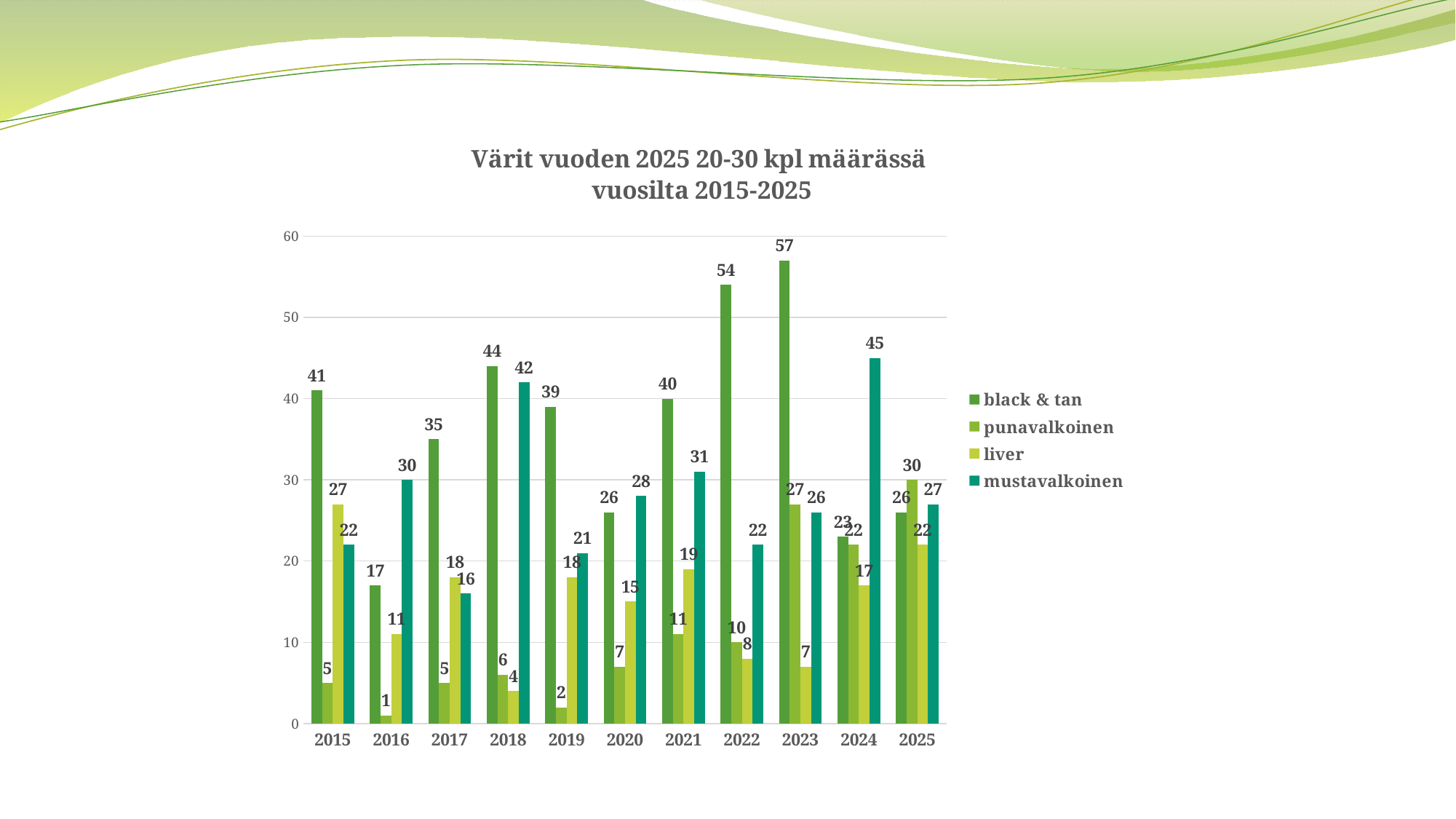
How many series does the legend list? 4 What kind of chart is shown on the slide? bar chart What is the value for black & tan in 2023? 57 Which is larger in 2025: punavalkoinen or black & tan? punavalkoinen What is the value for liver in 2015? 27 How many years are shown on the x axis? 11 What is the title of the chart? Värit vuoden 2025 20-30 kpl määrässä vuosilta 2015-2025 In which year is the punavalkoinen value lowest? 2016 In which year is the black & tan value highest? 2023 What is the value for punavalkoinen in 2016? 1 What is the value for mustavalkoinen in 2024? 45 What is the difference between the black & tan value in 2022 and the black & tan value in 2024? 31